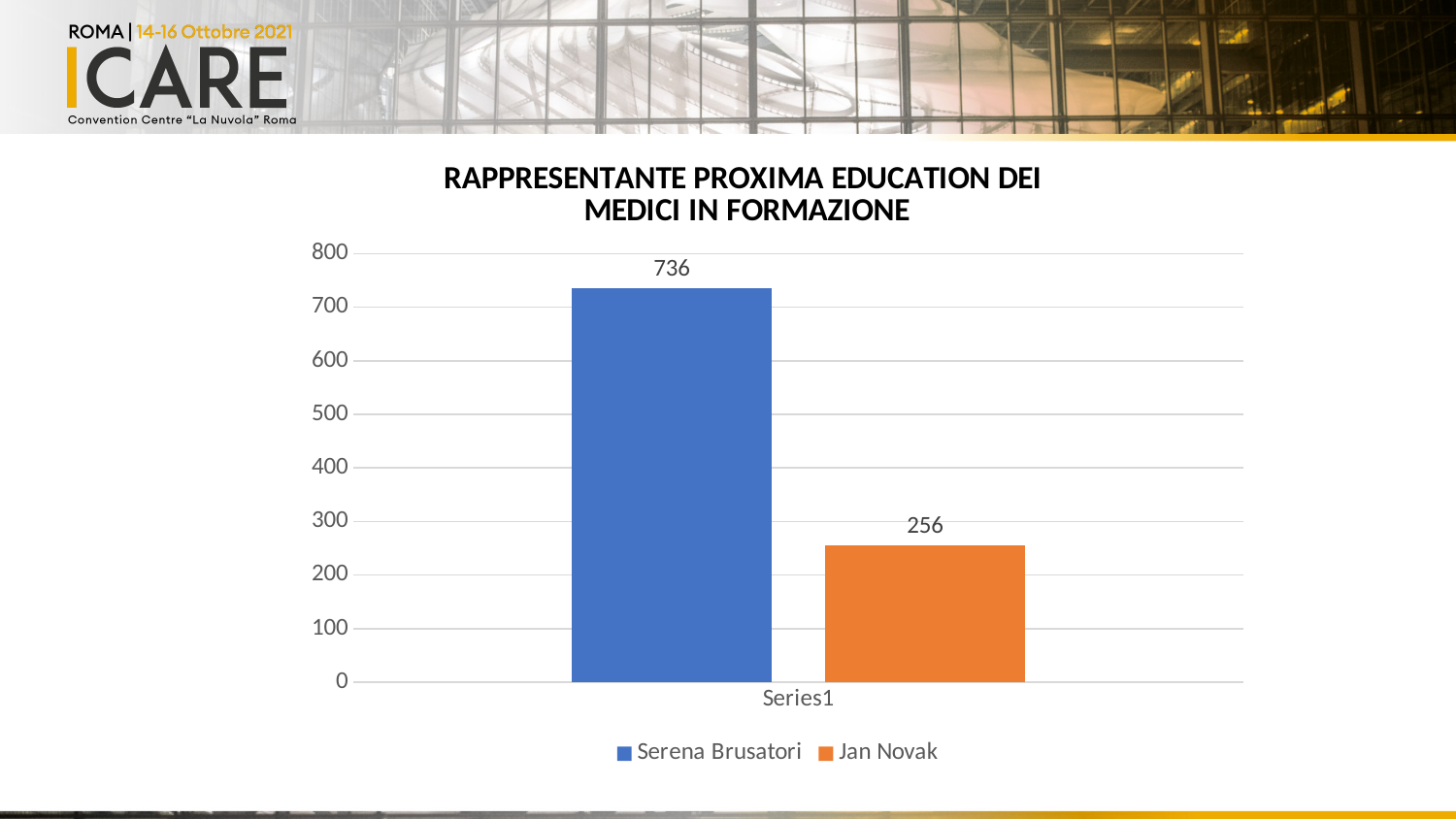
What colour is the bar for Jan Novak? orange Which is larger, the value for Serena Brusatori or the value for Jan Novak? Serena Brusatori Is the value for Jan Novak greater or less than 300? less Is the value for Serena Brusatori greater or less than 700? greater Which candidate has the highest value? Serena Brusatori What is the value for Jan Novak? 256 What is the total of the two values shown in the chart? 992 What is the difference between the values for Serena Brusatori and Jan Novak? 480 What kind of chart is shown on the slide? bar chart Which candidate has the lowest value? Jan Novak What is the value for Serena Brusatori? 736 How many series does the legend list? 2